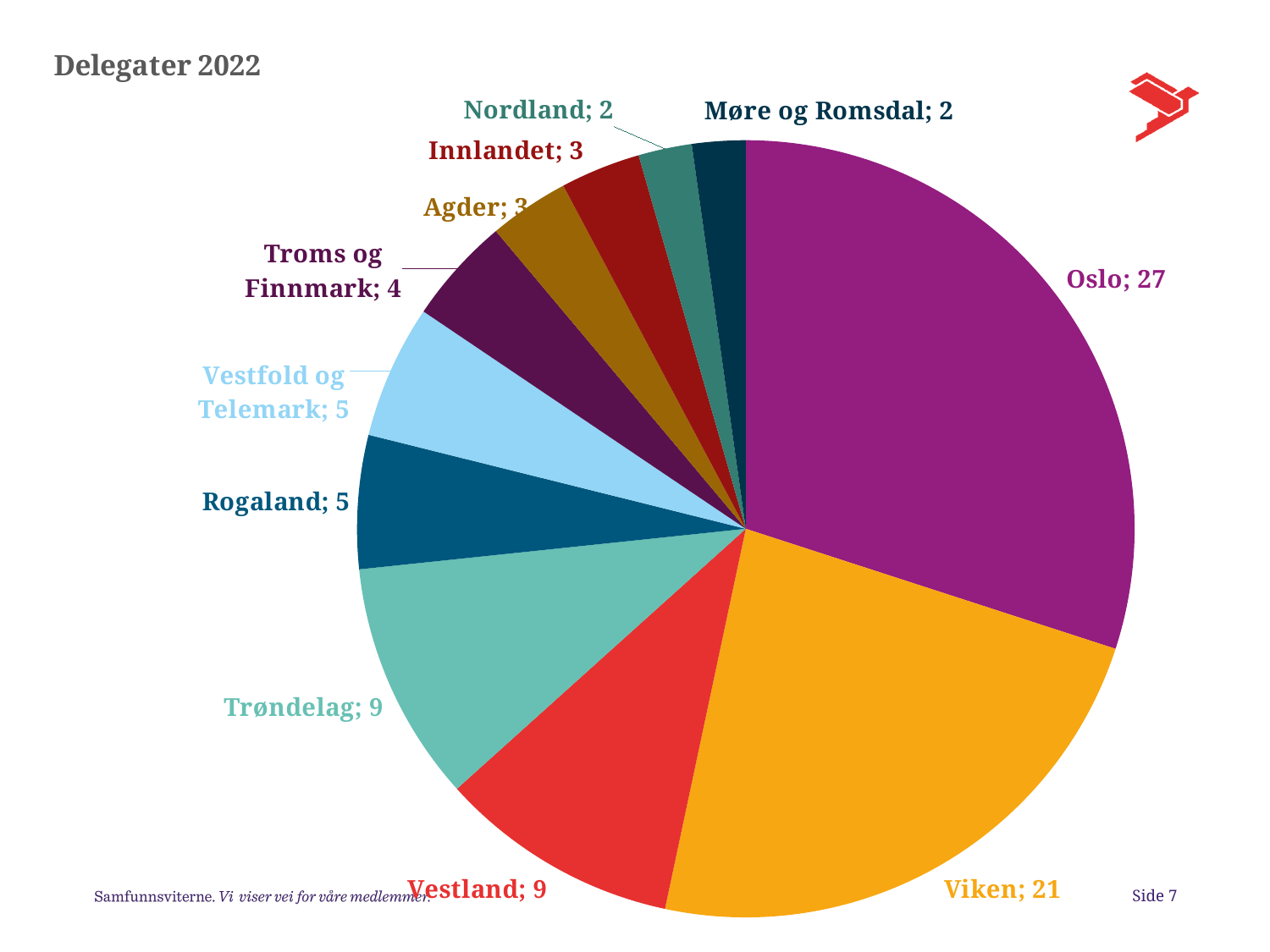
Which region has the largest slice of the pie? Oslo What colour is the Viken slice? orange What is the difference between the values for Oslo and Viken? 6 What is the value for Troms og Finnmark? 4 How many delegates does Oslo have? 27 What is the title of the chart? Delegater 2022 How many regions (slices) are shown in the pie chart? 11 Which is larger, the value for Vestland or the value for Rogaland? Vestland What is the value for Viken? 21 What kind of chart is shown on the slide? pie chart What share of the total does Oslo represent? 30% What is the value for Nordland? 2